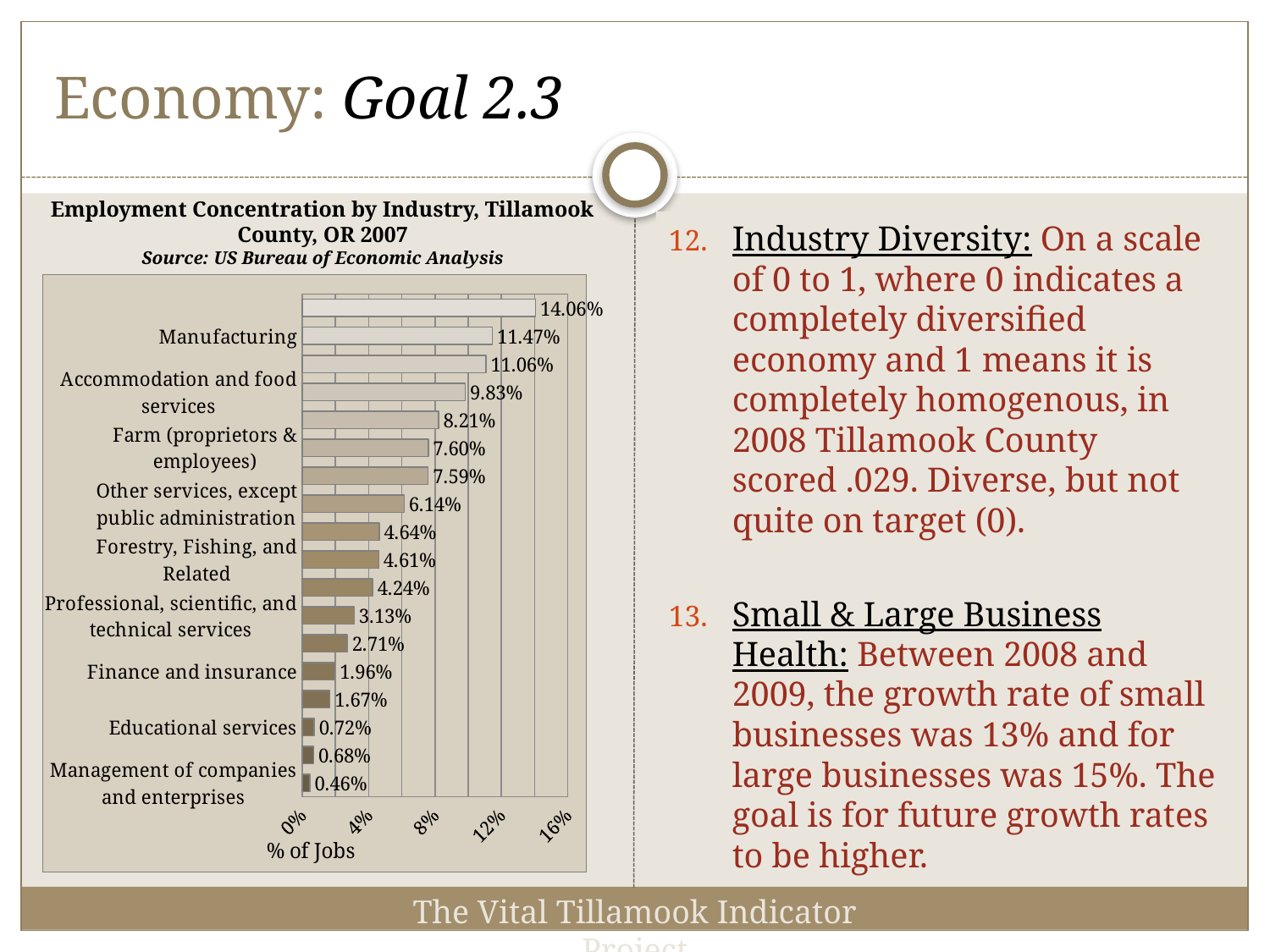
Which has a larger share of jobs: Finance and insurance or Professional, scientific, and technical services? Professional, scientific, and technical services Which labeled industry has the lowest percentage of jobs, and what is its value? Management of companies and enterprises, 0.46% What is the label on the horizontal axis of the chart? % of Jobs What is the highest value shown on any bar in the chart? 14.06% What percentage of jobs is shown for Farm (proprietors & employees)? 7.60% What percentage of jobs is shown for Accommodation and food services? 9.83% What is the difference in percentage points between Manufacturing and Accommodation and food services? 1.64 percentage points What is the title of the chart? Employment Concentration by Industry, Tillamook County, OR 2007 What percentage of jobs is shown for Educational services? 0.72% What percentage of jobs is shown for Manufacturing? 11.47% What percentage of jobs is shown for Forestry, Fishing, and Related? 4.61% What type of chart is shown on the slide? Bar chart